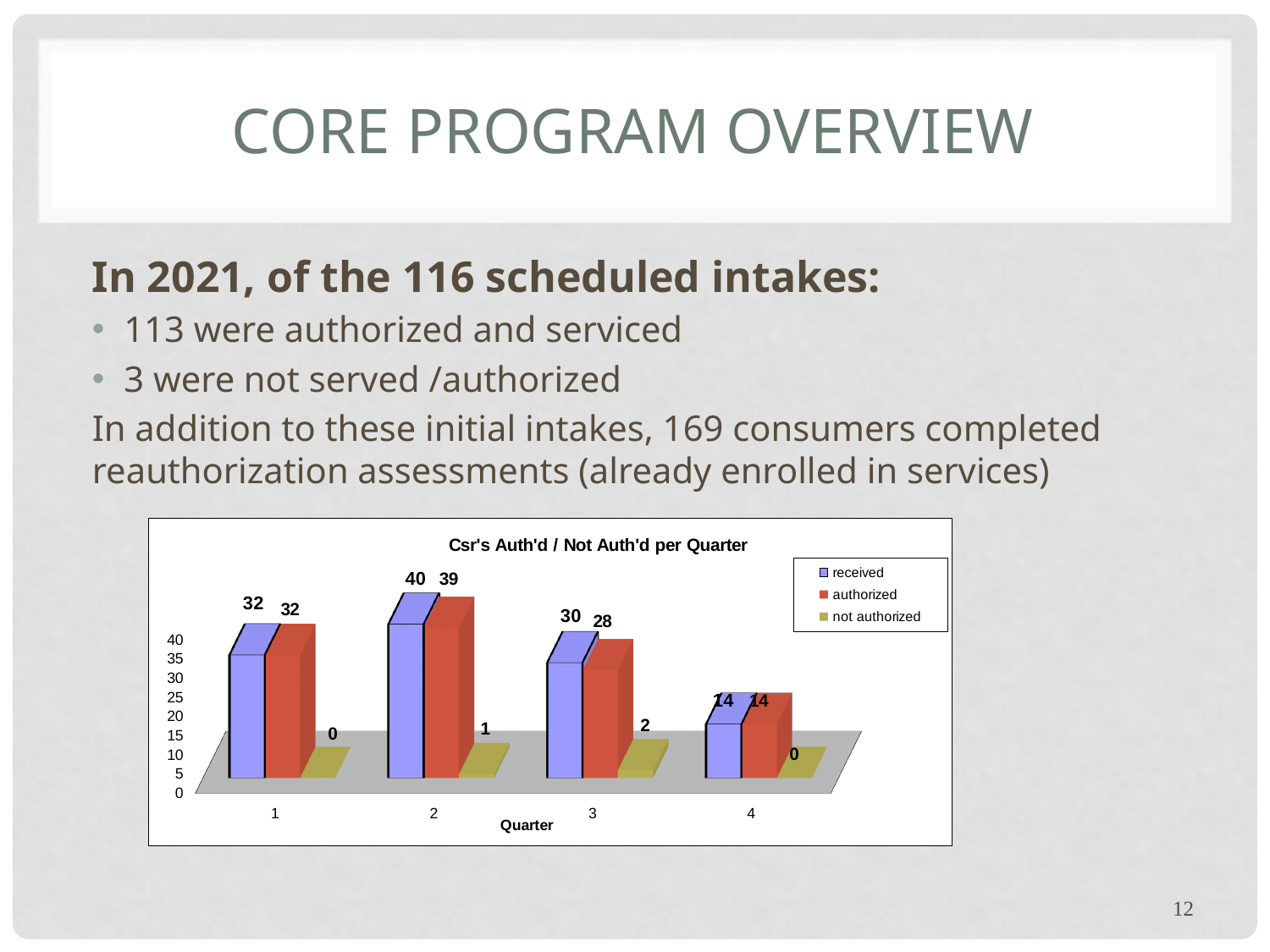
What is the difference between 'received' and 'authorized' in Quarter 3? 2 What is the title of the chart? Csr's Auth'd / Not Auth'd per Quarter Which quarter has the highest 'received' value? 2 What is the value for 'not authorized' in Quarter 3? 2 What is the value for 'received' in Quarter 2? 40 How many series does the legend list? 3 What kind of chart is shown on the slide? bar chart What is the value for 'authorized' in Quarter 3? 28 Do the 'received' values rise or fall from Quarter 2 to Quarter 4? fall Which is larger, the 'received' value in Quarter 1 or the 'received' value in Quarter 4? Quarter 1 How many quarters are shown on the x axis? 4 Which quarter has the lowest 'authorized' value? 4